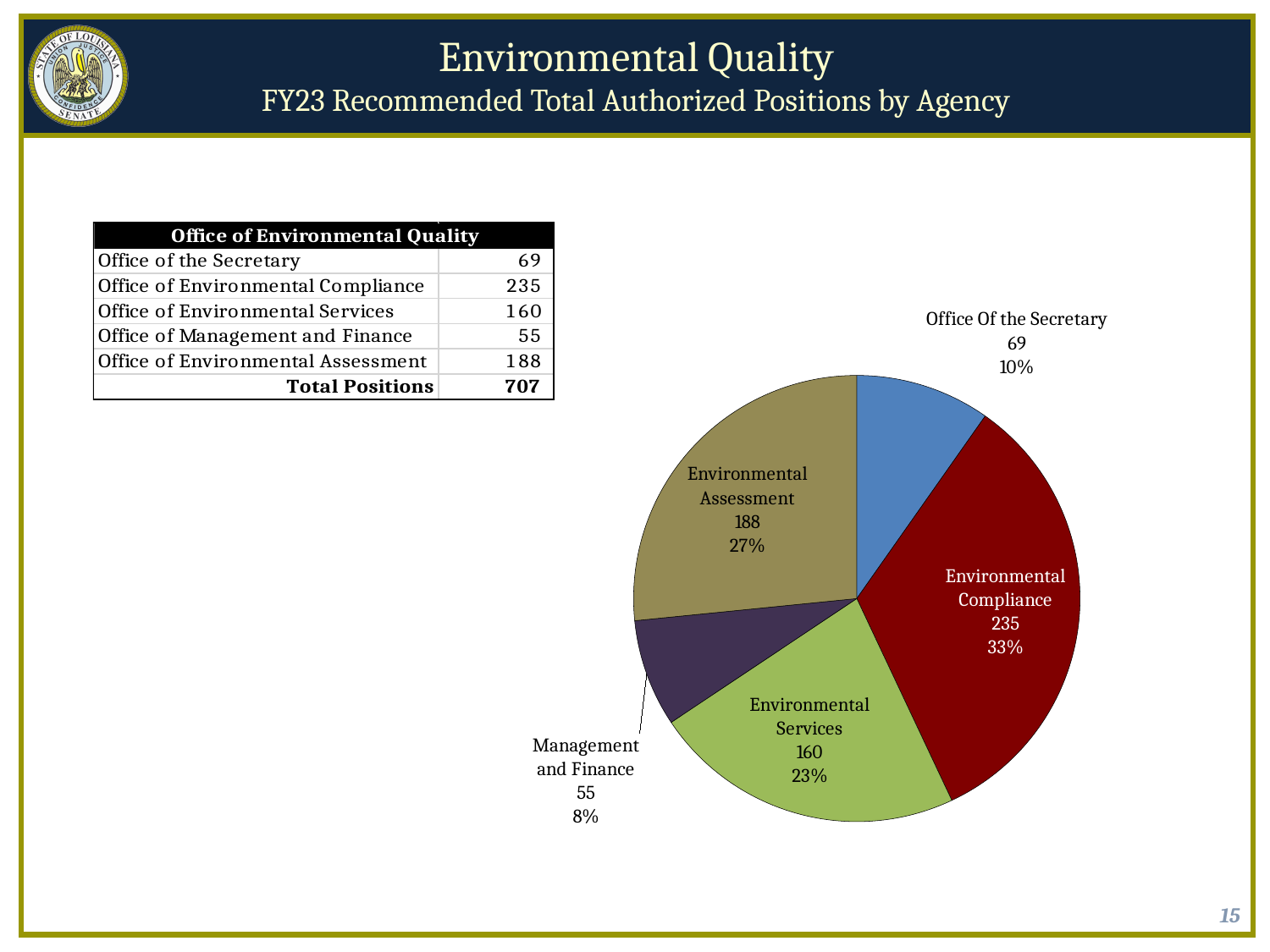
How many slices does the pie chart have? 5 What kind of chart is shown on the slide? pie chart What is the total number of positions across all slices of the pie chart? 707 How many positions does the Management and Finance slice show? 55 How many positions does the Environmental Compliance slice show? 235 Which office has the largest slice of the pie chart? Environmental Compliance What is the difference in positions between Environmental Compliance and Environmental Services? 75 What colour is the Environmental Services slice? green Which office has the smallest slice of the pie chart? Management and Finance Which has more positions, Environmental Assessment or Environmental Services? Environmental Assessment What percentage share does the Environmental Assessment slice show? 27% What percentage share does the Office Of the Secretary slice show? 10%